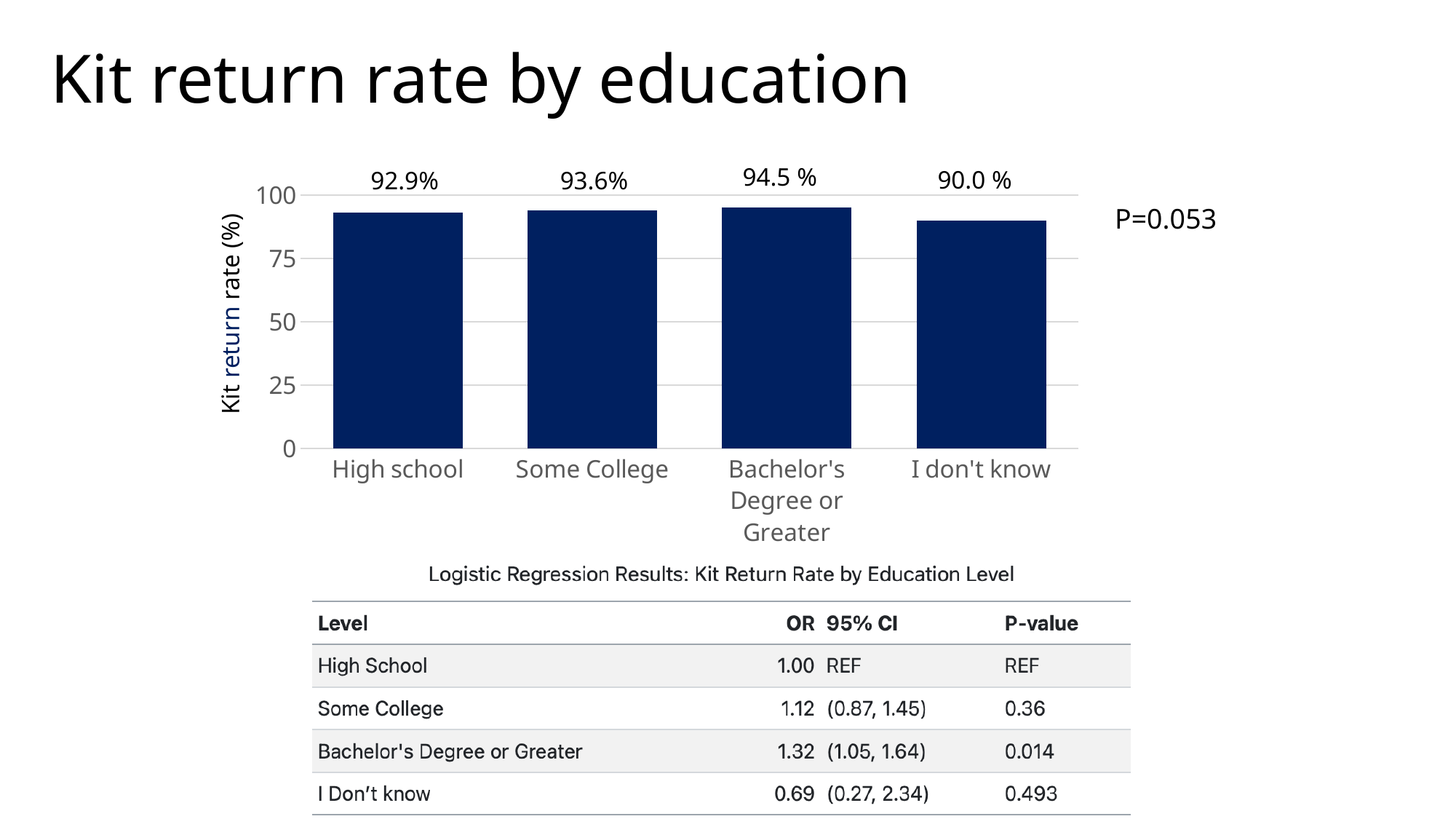
What is the kit return rate for Bachelor's Degree or Greater? 94.5 % What is the kit return rate for Some College? 93.6% Which education category has the highest kit return rate? Bachelor's Degree or Greater How many education categories are shown in the bar chart? 4 Which has a higher kit return rate, High school or Some College? Some College What is the label on the y-axis of the chart? Kit return rate (%) Is the kit return rate for 'I don't know' greater or less than 75? greater What type of chart is used to show kit return rate by education? Bar chart What is the difference in kit return rate between Bachelor's Degree or Greater and 'I don't know'? 4.5 percentage points What is the kit return rate for High school? 92.9% Which education category has the lowest kit return rate? I don't know What is the kit return rate for the 'I don't know' category? 90.0 %